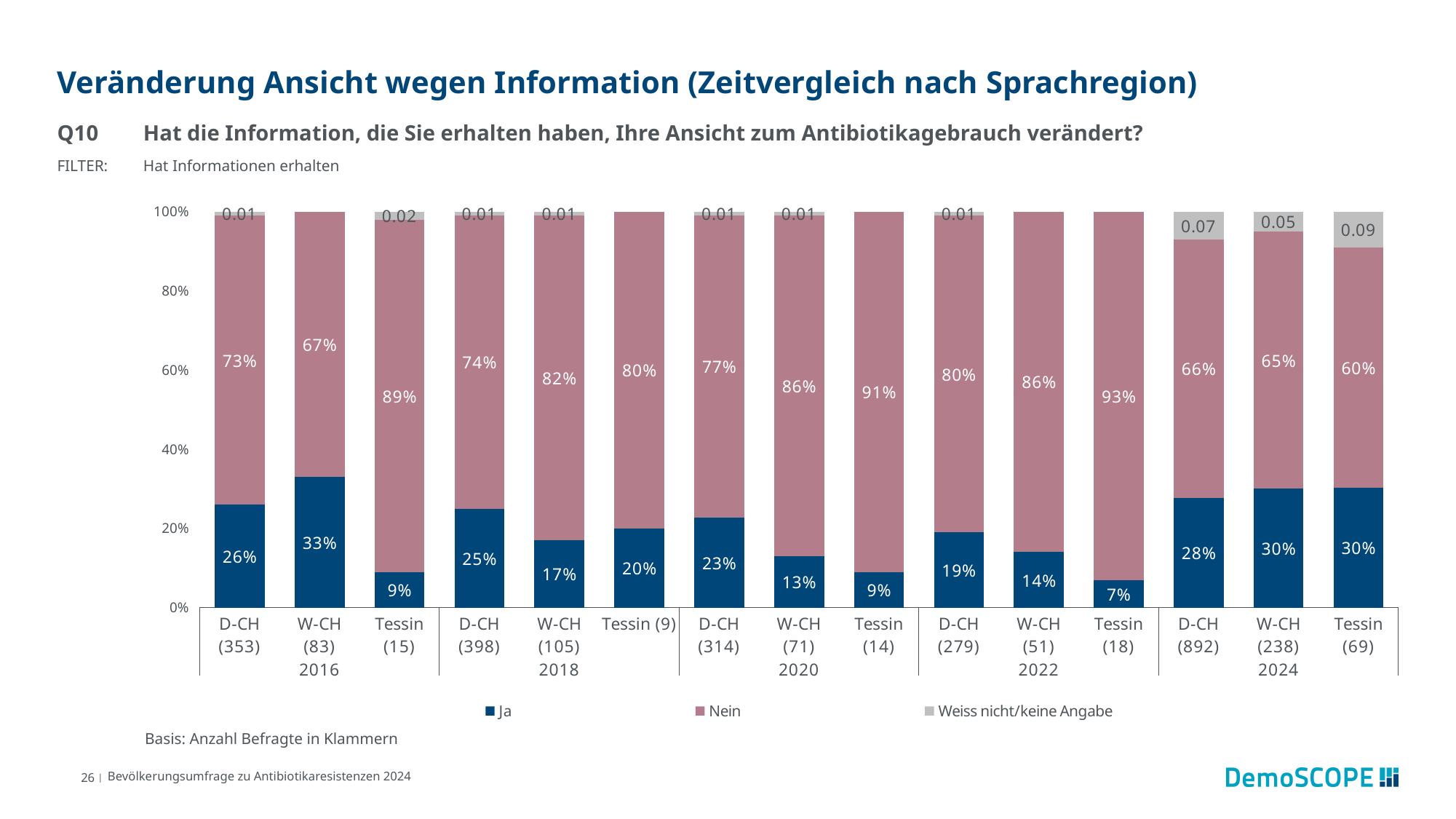
Which series is shown in grey in the legend? Weiss nicht/keine Angabe What is the difference between the "Nein" values for Tessin and D-CH in 2024? 6 percentage points What percentage of D-CH respondents in 2016 answered "Ja"? 26% How many bars are shown in the chart? 15 Does the "Ja" share for D-CH rise or fall from 2016 to 2022? Fall Which bar has the highest "Ja" share? W-CH 2016 (33%) Which bar has the lowest "Ja" share? Tessin 2022 (7%) What is the "Nein" value for Tessin in 2022? 93% How many series does the legend list? 3 What type of chart is shown on the slide? Stacked bar chart What is the "Ja" value for W-CH in 2024? 30% Which is larger, the "Ja" share for D-CH in 2020 or for W-CH in 2020? D-CH in 2020 (23%)